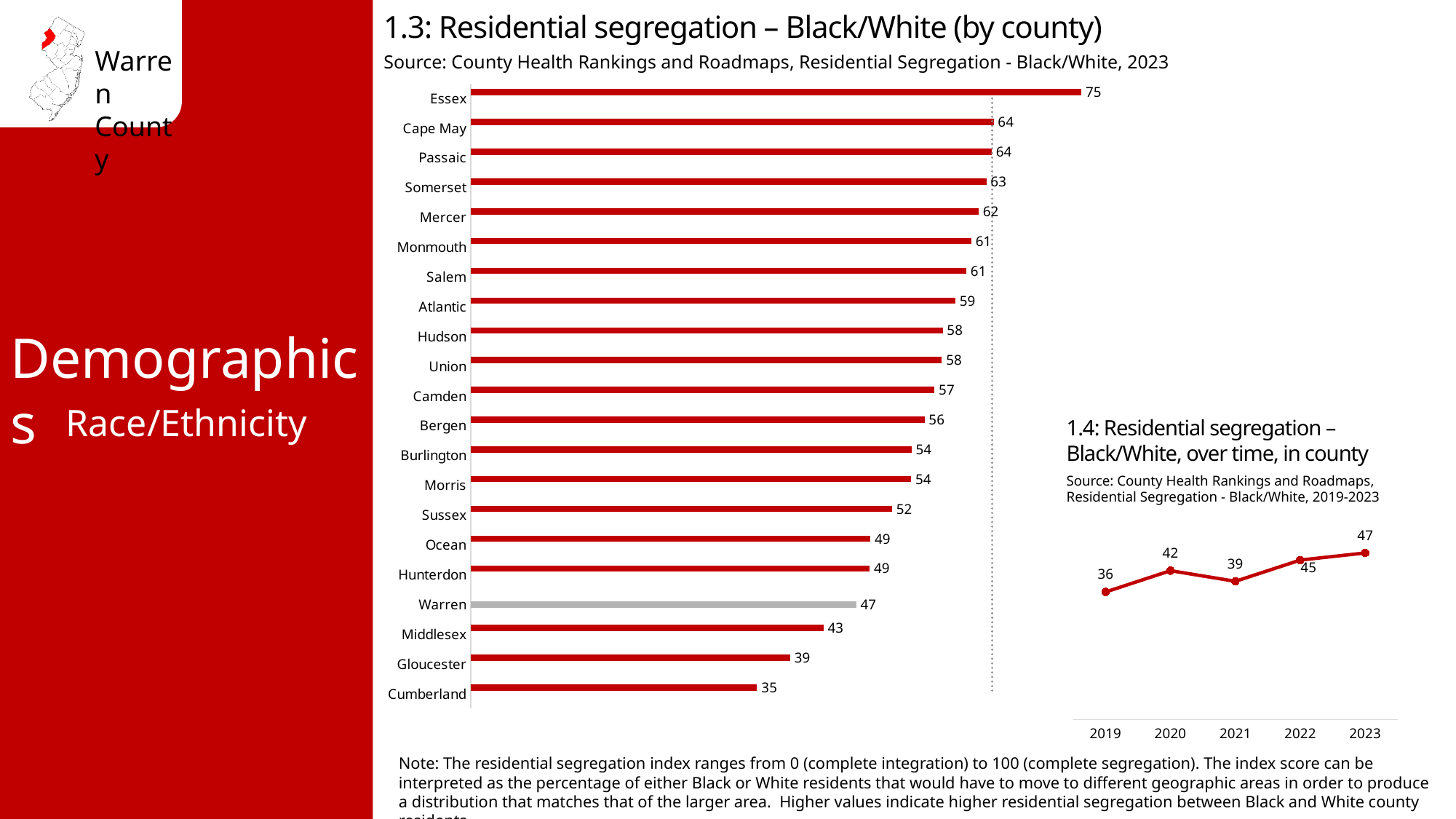
In chart 1.3 (Residential segregation – Black/White by county), how many counties are shown? 21 In chart 1.3 (Residential segregation – Black/White by county), what is the difference between the values for Essex and Cumberland? 40 In chart 1.3 (Residential segregation – Black/White by county), which is larger, the value for Sussex or the value for Middlesex? Sussex In chart 1.4 (Residential segregation – Black/White, over time, in county), what is the value for 2019? 36 In chart 1.3 (Residential segregation – Black/White by county), what is the value for Warren? 47 In chart 1.4 (Residential segregation – Black/White, over time, in county), which year has the highest value? 2023 What kind of chart is chart 1.3 (Residential segregation – Black/White by county)? Bar chart In chart 1.3 (Residential segregation – Black/White by county), which county has the highest value? Essex In chart 1.4 (Residential segregation – Black/White, over time, in county), what is the difference between the 2023 and 2019 values? 11 In chart 1.3 (Residential segregation – Black/White by county), what is the value for Gloucester? 39 In chart 1.4 (Residential segregation – Black/White, over time, in county), how many years are plotted? 5 In chart 1.3 (Residential segregation – Black/White by county), which county has the lowest value? Cumberland